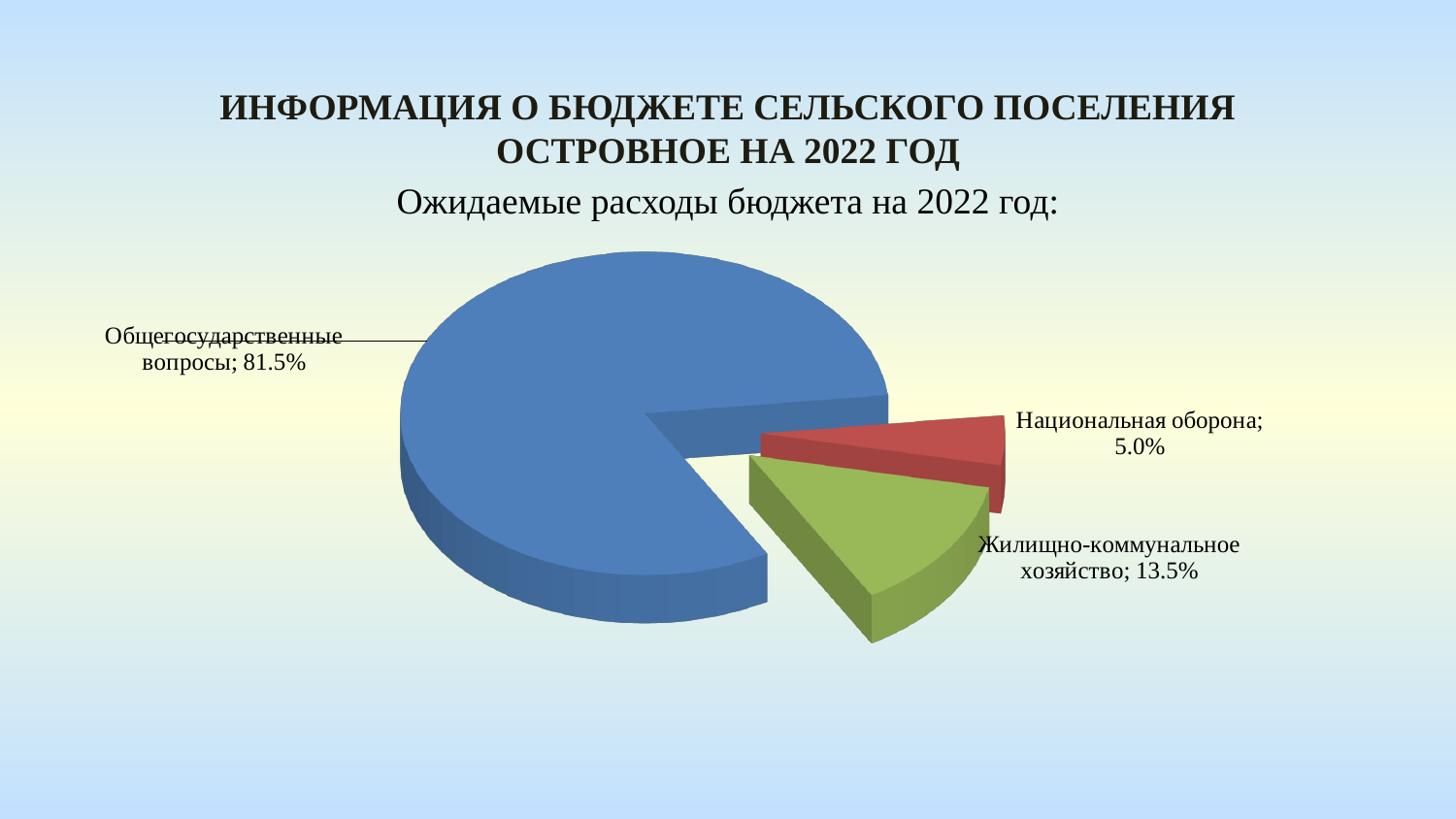
Which is larger: the share of Жилищно-коммунальное хозяйство or the share of Национальная оборона? Жилищно-коммунальное хозяйство Which category has the smallest slice of the pie? Национальная оборона What share of the pie does Жилищно-коммунальное хозяйство have? 13.5% What is the difference between the shares of Жилищно-коммунальное хозяйство and Национальная оборона? 8.5% What colour is the slice for Национальная оборона? Red What share of the pie does Общегосударственные вопросы have? 81.5% How many categories are shown in the pie chart? 3 What is the difference between the shares of Общегосударственные вопросы and Жилищно-коммунальное хозяйство? 68.0% What kind of chart is shown on the slide? Pie chart Which category has the largest slice of the pie? Общегосударственные вопросы What is the subtitle above the chart? Ожидаемые расходы бюджета на 2022 год: What share of the pie does Национальная оборона have? 5.0%